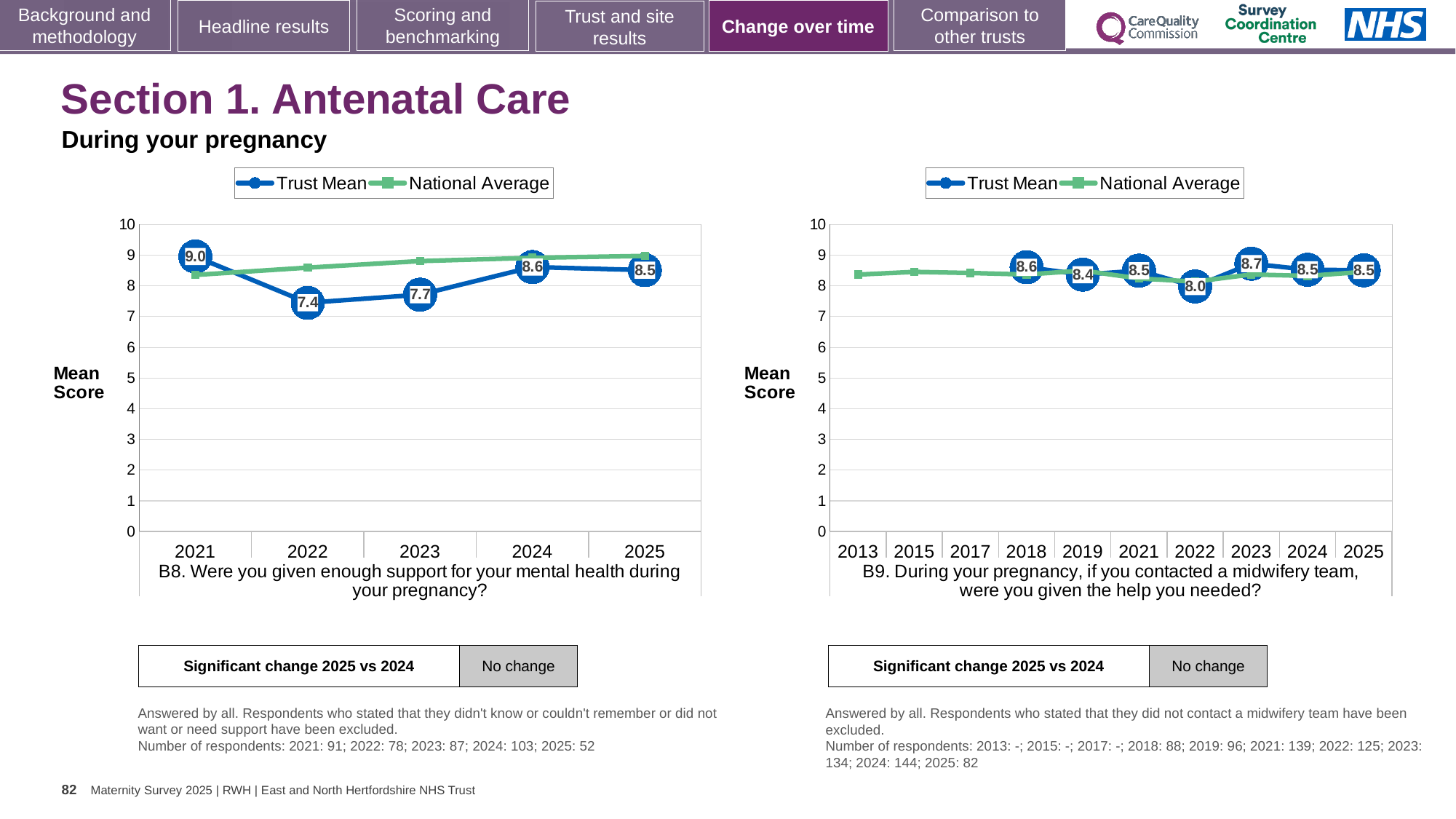
What type of chart is the left chart (B8)? Line chart In the right chart (B9), what is the Trust Mean for 2023? 8.7 In the right chart (B9), is the Trust Mean for 2018 larger or smaller than the Trust Mean for 2019? larger In the left chart (B8), how many years are shown on the x axis? 5 In the left chart (B8), which year has the lowest Trust Mean? 2022 In the right chart (B9), which year has the lowest Trust Mean? 2022 In the right chart (B9), what is the Trust Mean for 2022? 8.0 In the left chart (B8), which year has the highest Trust Mean? 2021 In the left chart (B8), what is the Trust Mean for 2022? 7.4 In the left chart (B8), what is the Trust Mean for 2021? 9.0 In the right chart (B9), how many series does the legend list? 2 In the left chart (B8), what is the difference between the Trust Mean in 2021 and 2022? 1.6